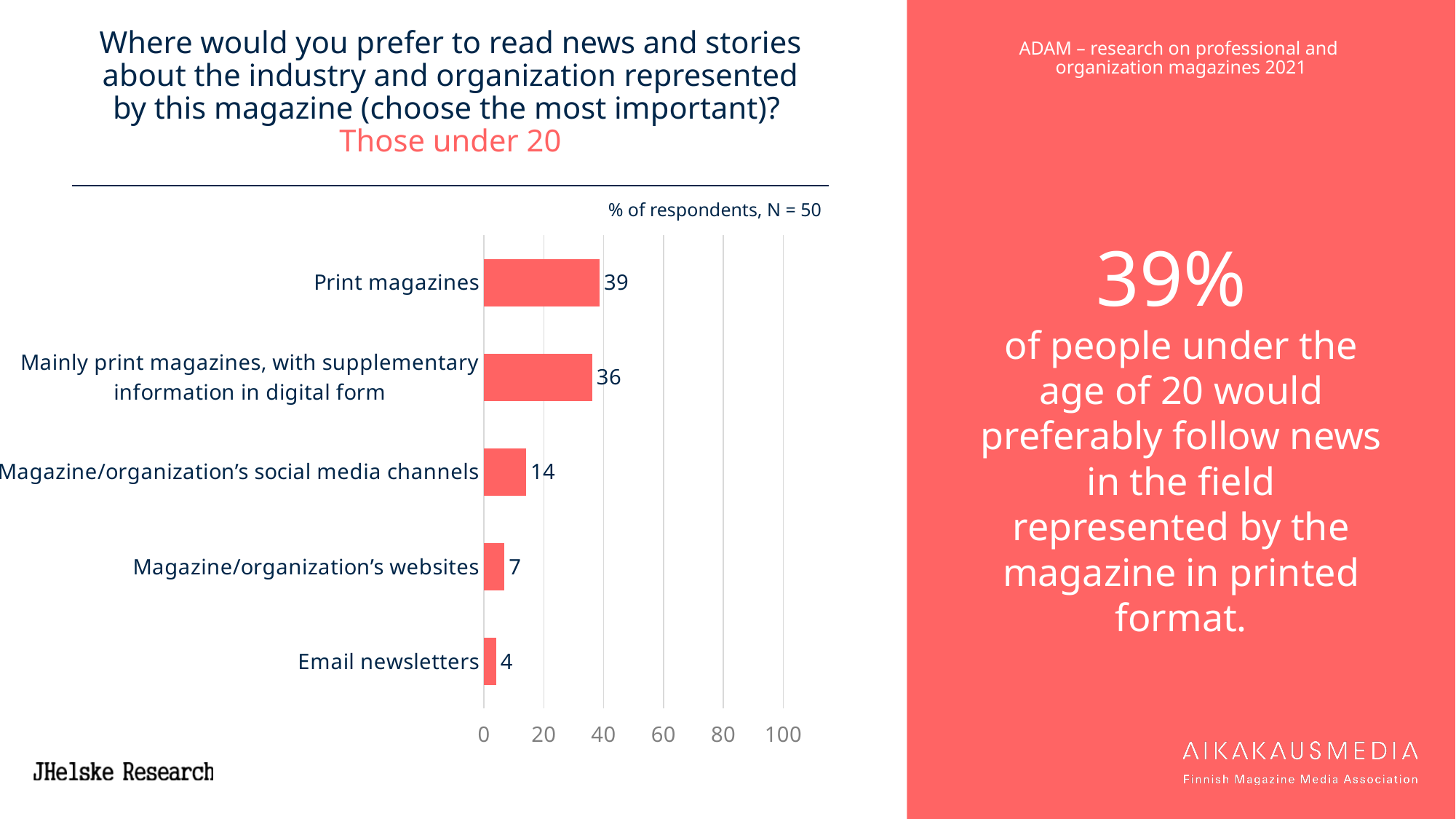
Which category has the highest value? Print magazines What is the value for 'Email newsletters'? 4 Which is larger: the value for 'Magazine/organization's social media channels' or 'Magazine/organization's websites'? Magazine/organization's social media channels What is the value for 'Mainly print magazines, with supplementary information in digital form'? 36 How many respondents (N) does the chart note say were surveyed? 50 What kind of chart is shown on the slide? Bar chart Which category has the lowest value? Email newsletters What is the value for 'Magazine/organization's social media channels'? 14 How many categories are shown in the chart? 5 What percentage of respondents under 20 prefer print magazines? 39 Is the value for 'Print magazines' greater or less than 20? greater What is the difference between the values for 'Print magazines' and 'Magazine/organization's websites'? 32